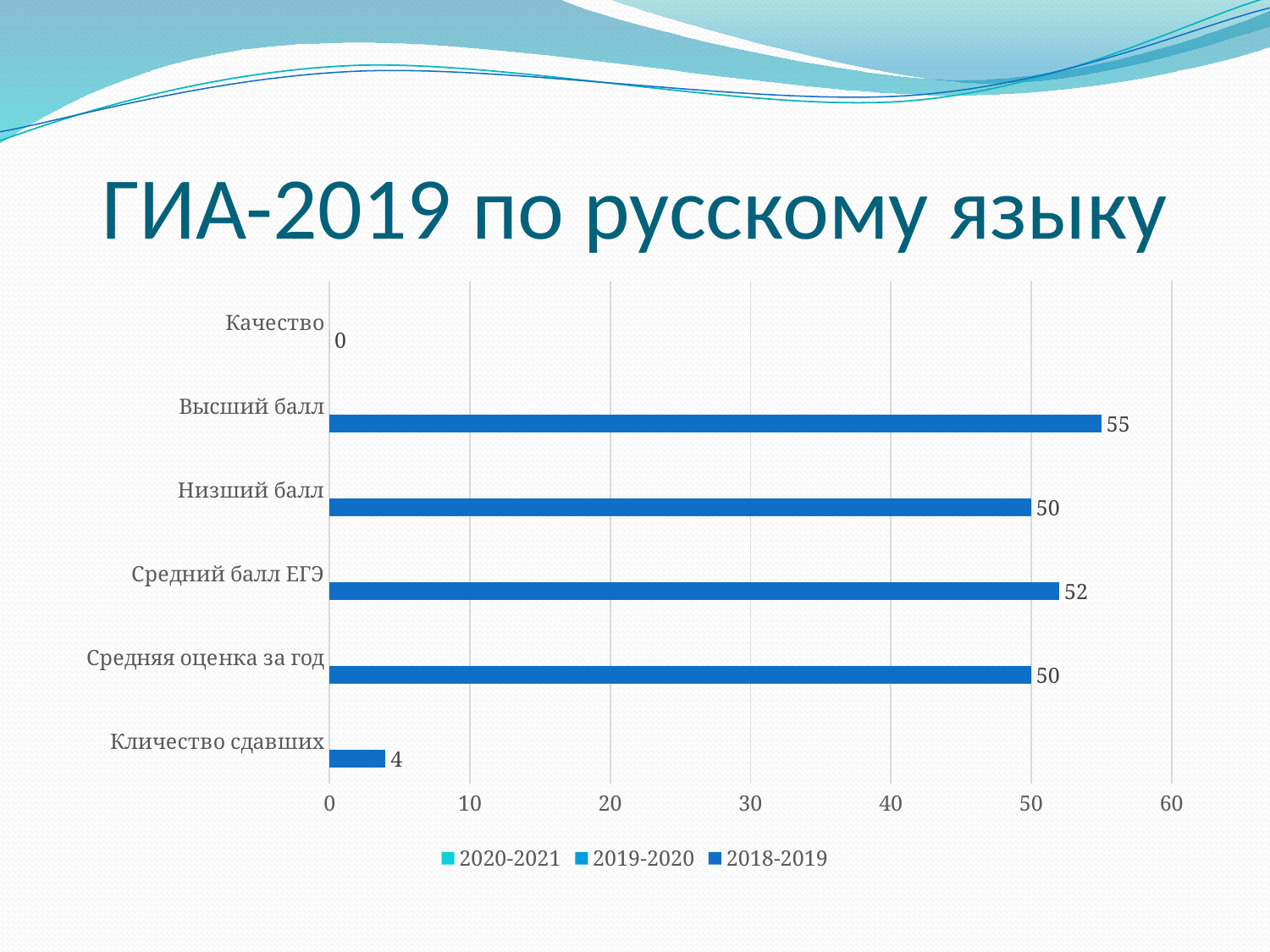
What is the value for Высший балл? 55 Is the value for Высший балл greater or less than 50? greater What kind of chart is shown on the slide? bar chart Which is larger, the value for Средний балл ЕГЭ or the value for Средняя оценка за год? Средний балл ЕГЭ What is the value for Кличество сдавших? 4 How many categories are shown on the chart? 6 What is the value for Качество? 0 Which category has the lowest value? Качество Which category has the highest value? Высший балл What is the difference between the values for Высший балл and Низший балл? 5 What is the value for Средний балл ЕГЭ? 52 How many series does the legend list? 3